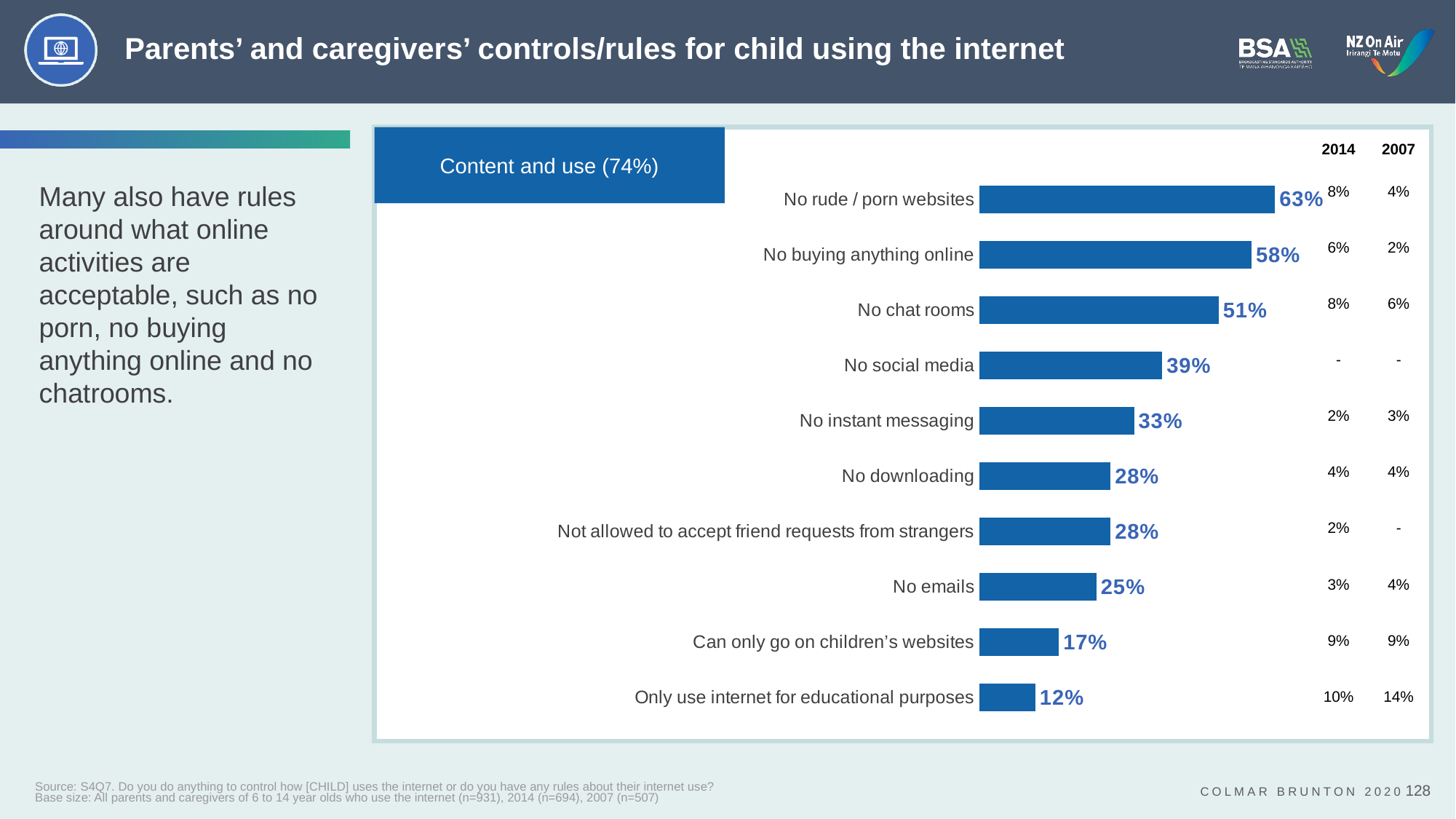
How many rules (categories) are shown in the bar chart? 10 Which is larger, the value for 'No emails' or the value for 'Can only go on children's websites'? No emails What is the 2007 value shown for 'Only use internet for educational purposes'? 14% What percentage of parents and caregivers have a rule of no rude / porn websites? 63% What is the 2014 value shown for 'No chat rooms'? 8% What is the label of the blue header box above the chart? Content and use (74%) What kind of chart is shown on the slide? Bar chart Which rule has the lowest percentage in the chart? Only use internet for educational purposes What is the value for 'Only use internet for educational purposes'? 12% What is the difference between the values for 'No buying anything online' and 'No chat rooms'? 7% Which rule has the highest percentage in the chart? No rude / porn websites What is the value for 'No social media'? 39%